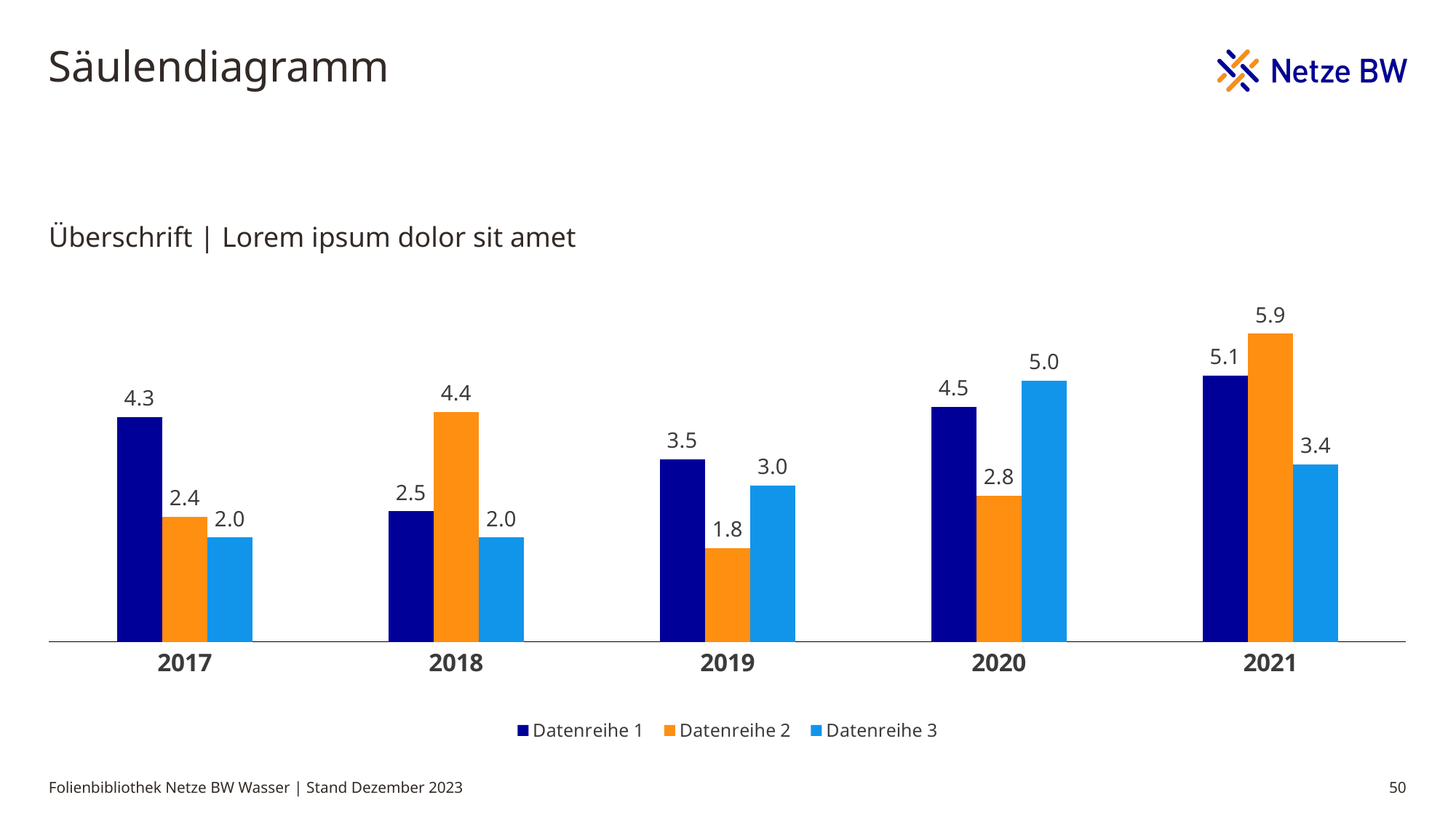
How many years are shown on the x axis? 5 In which year is Datenreihe 1 lowest? 2018 Does Datenreihe 3 rise or fall from 2019 to 2020? Rise What is the difference between Datenreihe 3 and Datenreihe 2 in 2020? 2.2 What kind of chart is shown on the slide? Bar chart What is the title of the slide? Säulendiagramm What is the value of Datenreihe 2 in 2021? 5.9 Which is larger in 2018: Datenreihe 1 or Datenreihe 2? Datenreihe 2 What is the value of Datenreihe 1 in 2017? 4.3 In which year is Datenreihe 2 highest? 2021 What is the value of Datenreihe 3 in 2019? 3.0 How many series does the legend list? 3